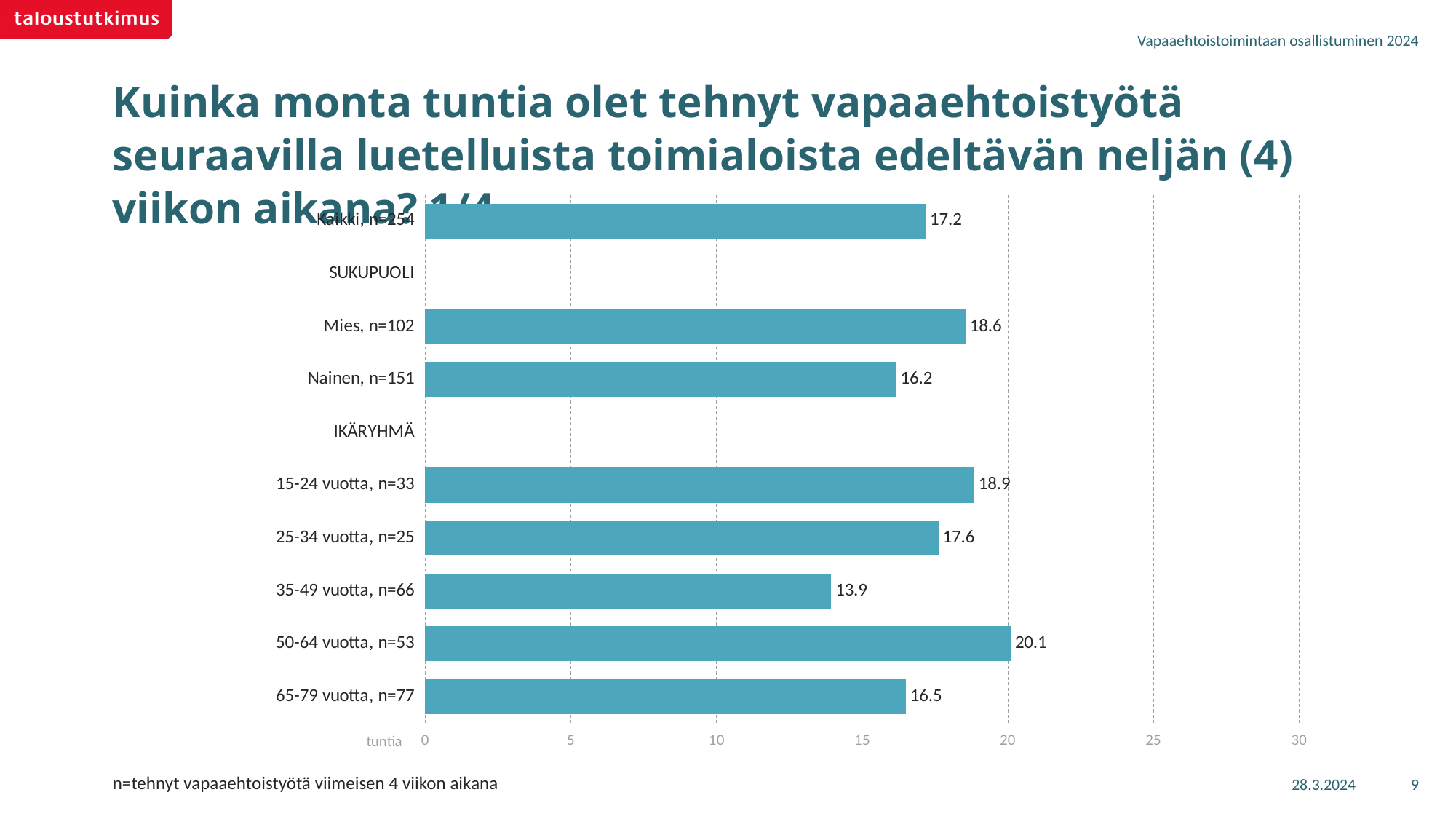
Which has the larger value, 15-24 vuotta, n=33 or 25-34 vuotta, n=25? 15-24 vuotta, n=33 What is the value for 35-49 vuotta, n=66? 13.9 Is the value for 50-64 vuotta, n=53 greater or less than 20? greater What kind of chart is shown on the slide? bar chart What is the value for Mies, n=102? 18.6 Which age group has the highest value? 50-64 vuotta, n=53 What is the value for 65-79 vuotta, n=77? 16.5 What is the value for Nainen, n=151? 16.2 Which age group has the lowest value? 35-49 vuotta, n=66 How many age groups (IKÄRYHMÄ) are plotted in the chart? 5 What unit label is shown at the bottom of the x axis? tuntia What is the difference between the values for Mies, n=102 and Nainen, n=151? 2.4